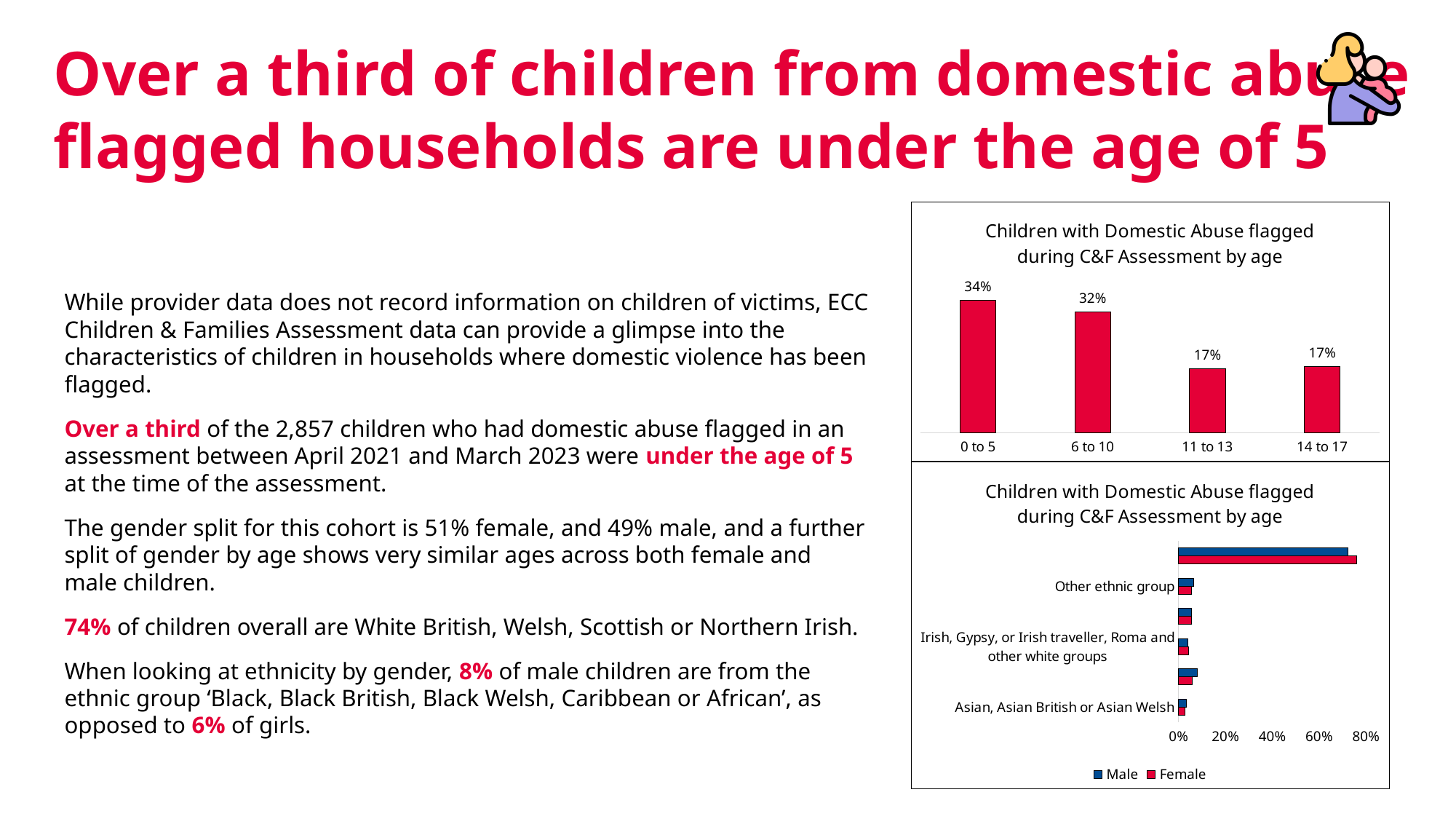
In the top chart, which age group has the highest percentage? 0 to 5 How many series does the legend of the bottom chart list? 2 In the top chart, what is the value for the 11 to 13 age group? 17% In the top chart, what percentage of children with domestic abuse flagged are aged 0 to 5? 34% What kind of chart is the top chart? Bar chart In the top chart, what is the difference between the 6 to 10 and 14 to 17 age groups? 15% In the top chart, what is the difference between the 0 to 5 and 6 to 10 age groups? 2% In the top chart, do the values generally rise or fall as age increases from 0 to 5 to 14 to 17? Fall In the top chart, which is larger, the value for 6 to 10 or the value for 14 to 17? 6 to 10 How many age groups are shown in the top chart? 4 In the bottom chart, is the Male value for 'Other ethnic group' greater or less than 20%? less In the top chart, what is the value for the 6 to 10 age group? 32%